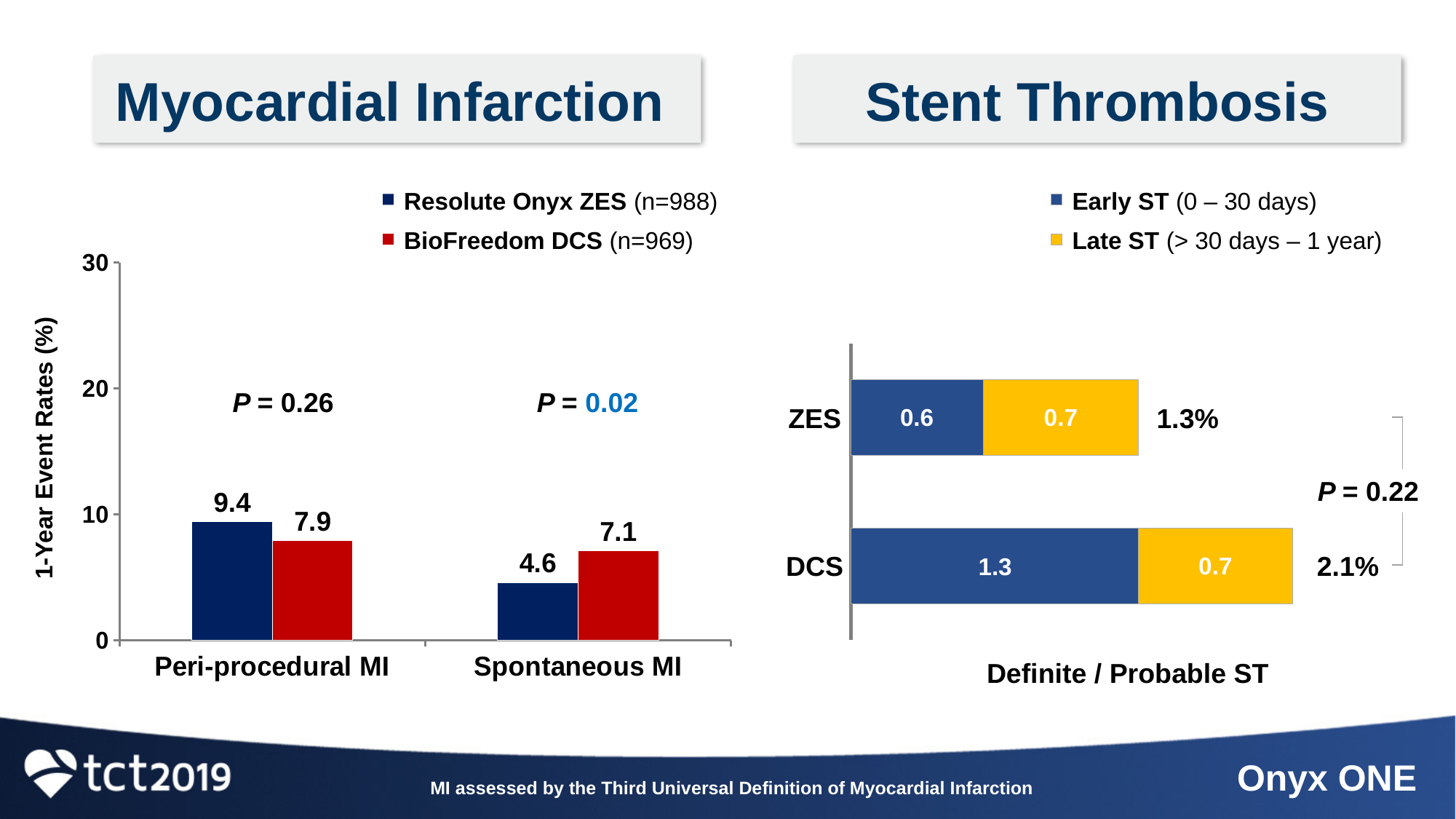
In the Myocardial Infarction chart, how many series does the legend list? 2 In the Stent Thrombosis chart, what is the total Definite / Probable ST rate for ZES? 1.3% In the Myocardial Infarction chart, what is the 1-year event rate for BioFreedom DCS for Spontaneous MI? 7.1 In the Myocardial Infarction chart, what is the difference between the BioFreedom DCS and Resolute Onyx ZES rates for Spontaneous MI? 2.5 In the Stent Thrombosis chart, which group has the higher total Definite / Probable ST rate, ZES or DCS? DCS In the Stent Thrombosis chart, what is the Early ST value for DCS? 1.3 In the Myocardial Infarction chart, what is the 1-year event rate for Resolute Onyx ZES for Peri-procedural MI? 9.4 In the Myocardial Infarction chart, which series has the higher rate for Peri-procedural MI? Resolute Onyx ZES In the Myocardial Infarction chart, what is the P value shown for Spontaneous MI? 0.02 What kind of chart is the Stent Thrombosis chart? Stacked bar chart In the Stent Thrombosis chart, what time window does the legend give for Late ST? > 30 days – 1 year In the Stent Thrombosis chart, what is the difference between the Early ST values for DCS and ZES? 0.7